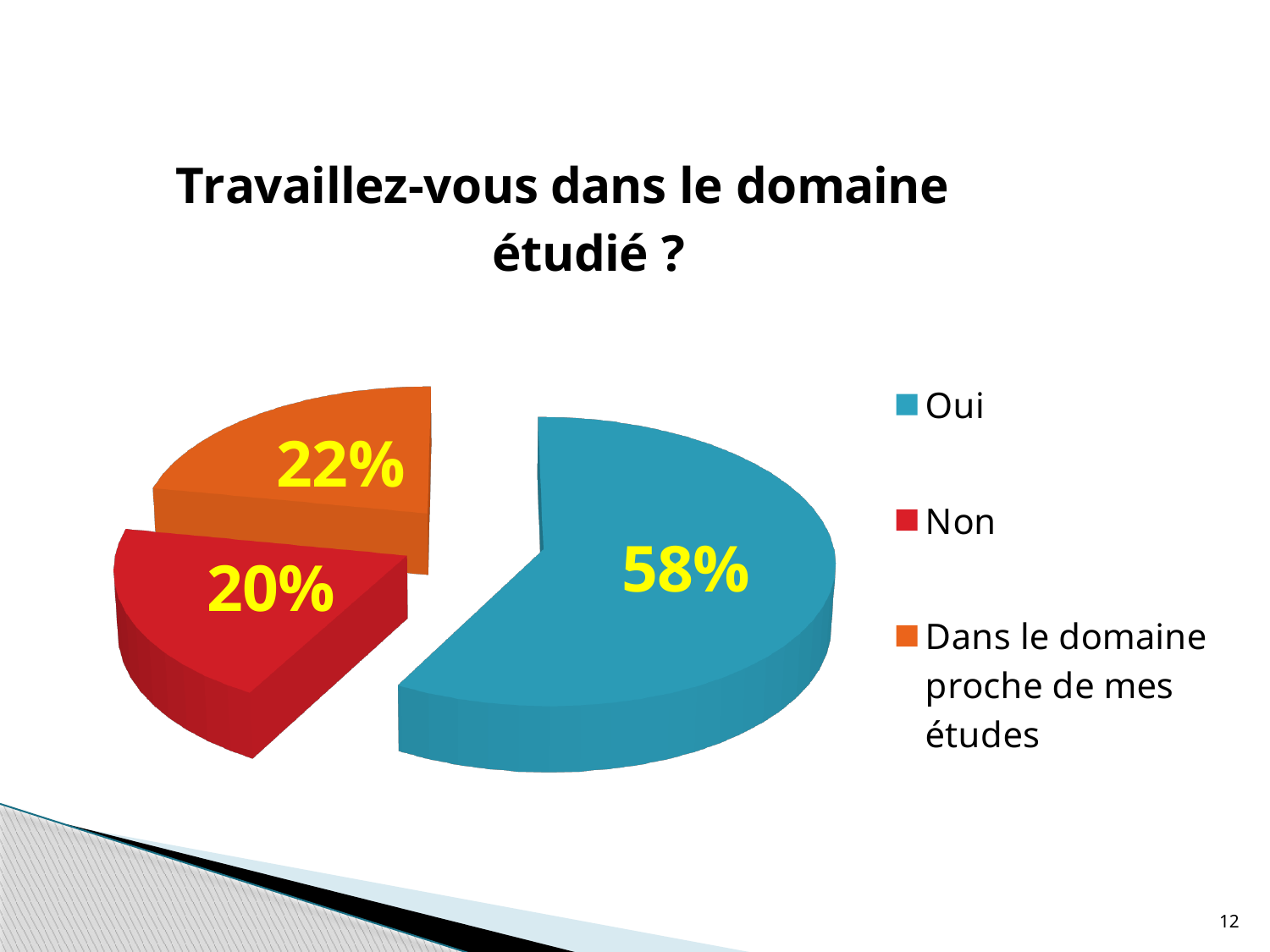
Which category has the smallest slice of the pie? Non What kind of chart is shown on the slide? Pie chart What is the difference in percentage points between "Dans le domaine proche de mes études" and "Non"? 2 What share of the pie does "Oui" represent? 58% How many entries does the legend list? 3 What share of the pie does "Dans le domaine proche de mes études" represent? 22% What is the title of the chart? Travaillez-vous dans le domaine étudié ? What is the difference in percentage points between "Oui" and "Non"? 38 What share of the pie does "Non" represent? 20% Which is larger, the slice for "Oui" or the slice for "Dans le domaine proche de mes études"? Oui Which category has the largest slice of the pie? Oui How many slices does the pie chart have? 3